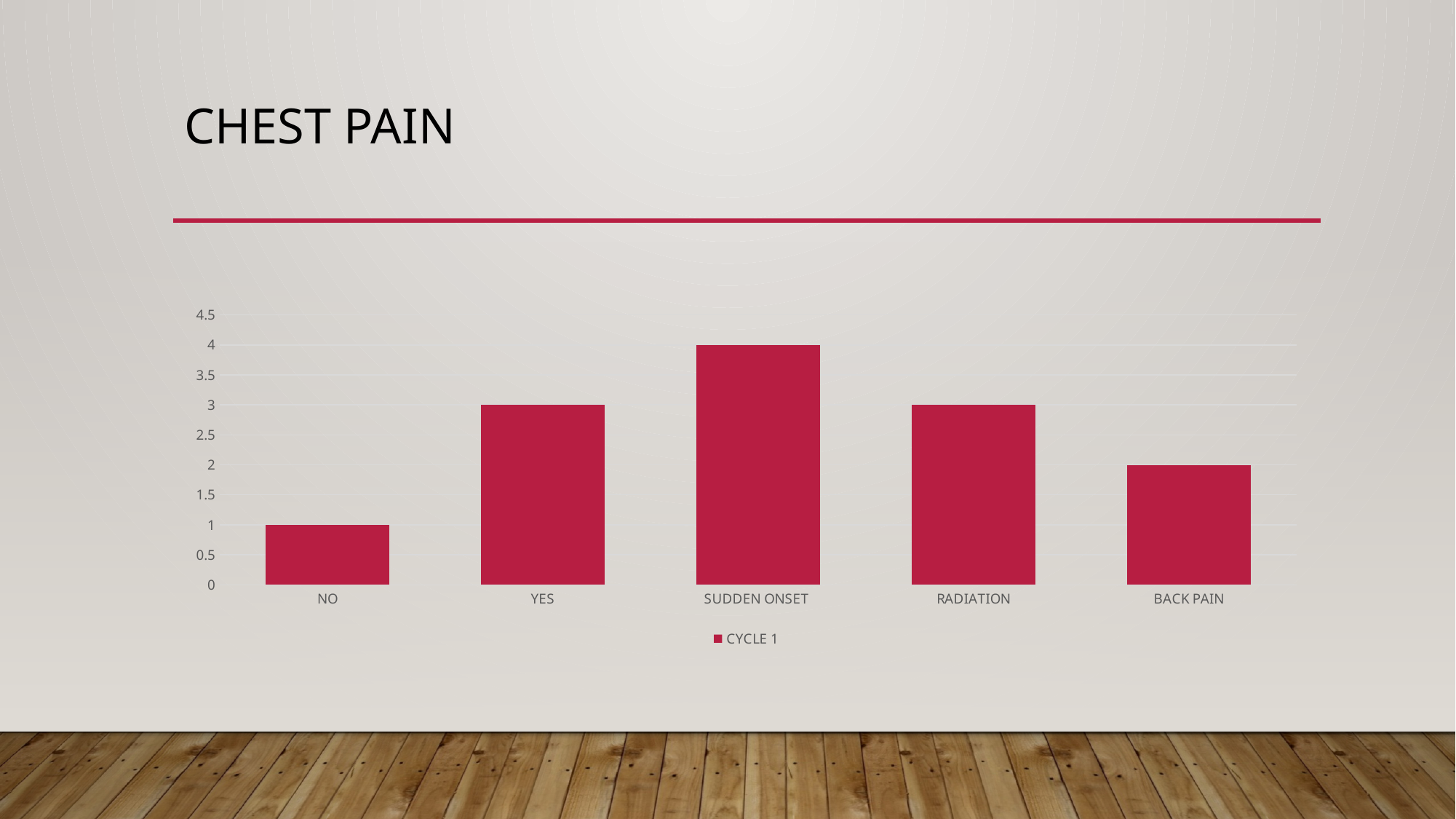
What is the value for BACK PAIN? 2 Which is larger, the value for YES or the value for BACK PAIN? YES Which category has the lowest value? NO Is the value for RADIATION greater or less than 2? greater What is the name of the series shown in the legend? CYCLE 1 What is the difference between the values for SUDDEN ONSET and NO? 3 How many categories are shown on the x axis? 5 Which category has the highest value? SUDDEN ONSET How many series does the legend list? 1 What kind of chart is shown on the slide? bar chart What is the value for SUDDEN ONSET? 4 What is the value for NO? 1